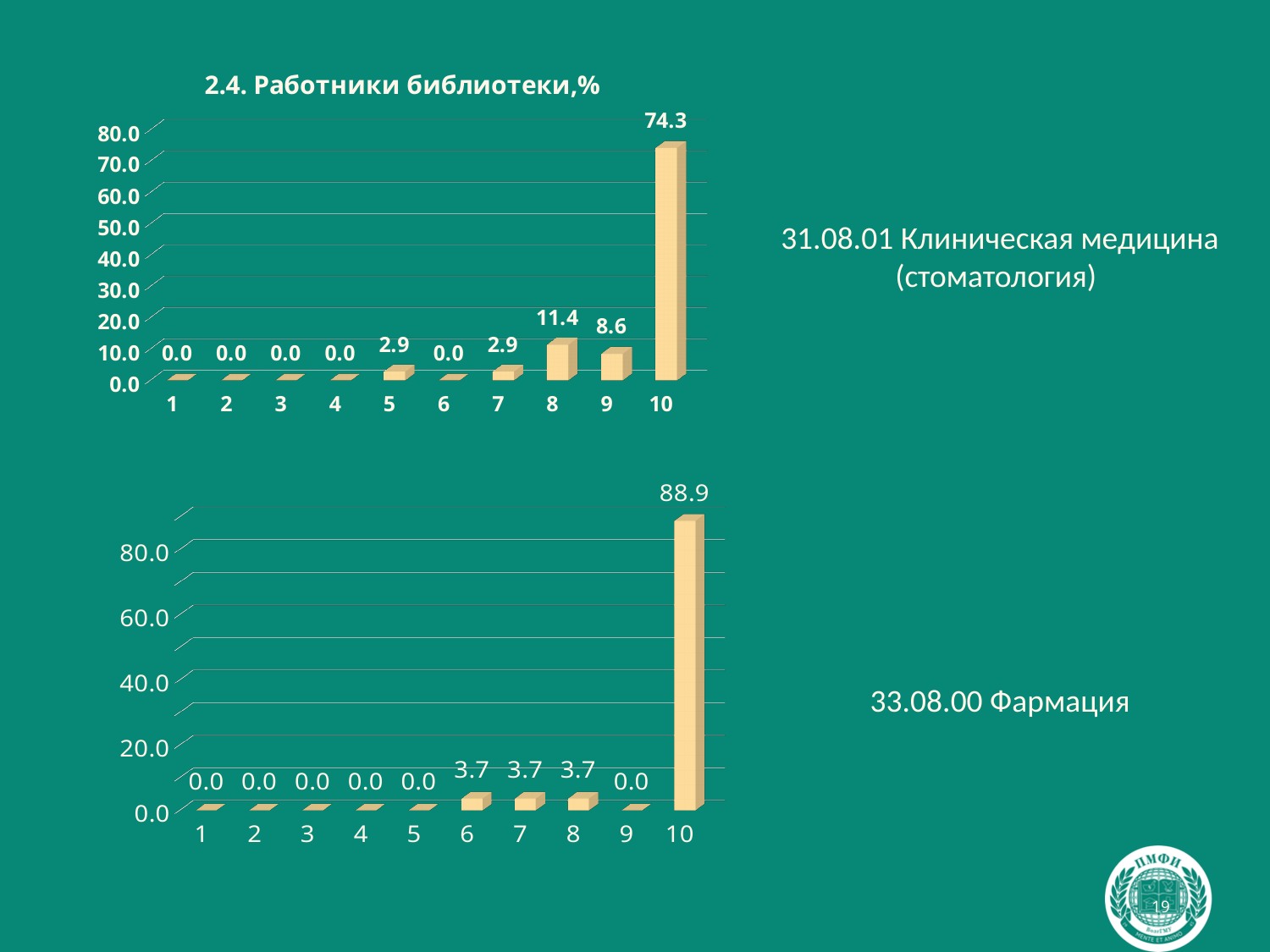
What kind of chart is the bottom chart? bar chart In the bottom chart, what is the difference between the values for category 10 and category 7? 85.2 In the bottom chart, what is the value for category 6? 3.7 In the top chart, what is the value for category 10? 74.3 In the top chart, what is the difference between the values for category 8 and category 9? 2.8 In the top chart, what is the value for category 9? 8.6 In the top chart, how many categories are shown on the x axis? 10 What is the title of the top chart? 2.4. Работники библиотеки,% In the top chart, which category has the highest value? 10 In the top chart, what is the value for category 8? 11.4 In the top chart, which is larger, the value for category 8 or category 9? category 8 In the bottom chart, what is the value for category 10? 88.9